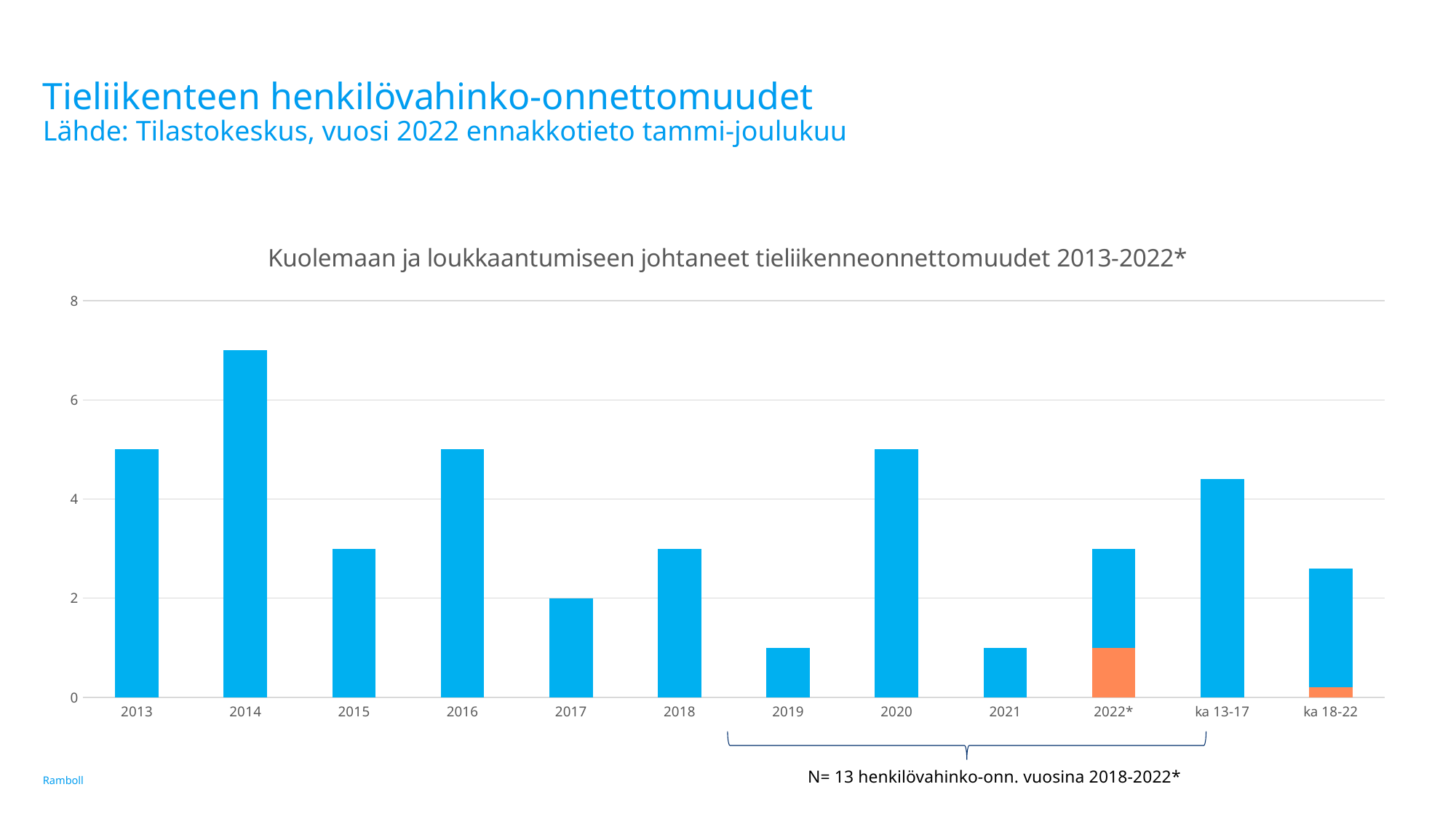
What kind of chart is shown on the slide? bar chart What is the value for 2017? 2 Which category has the highest bar in the chart? 2014 Is the value for 2015 greater or less than 4? less Which bars contain an orange segment? 2022* and ka 18-22 Is the value for 2014 greater or less than 6? greater What is the title of the chart? Kuolemaan ja loukkaantumiseen johtaneet tieliikenneonnettomuudet 2013-2022* Which is larger, the value for 2020 or the value for 2021? 2020 How many categories are shown on the x axis of the chart? 12 Is the value for 2013 greater or less than 4? greater